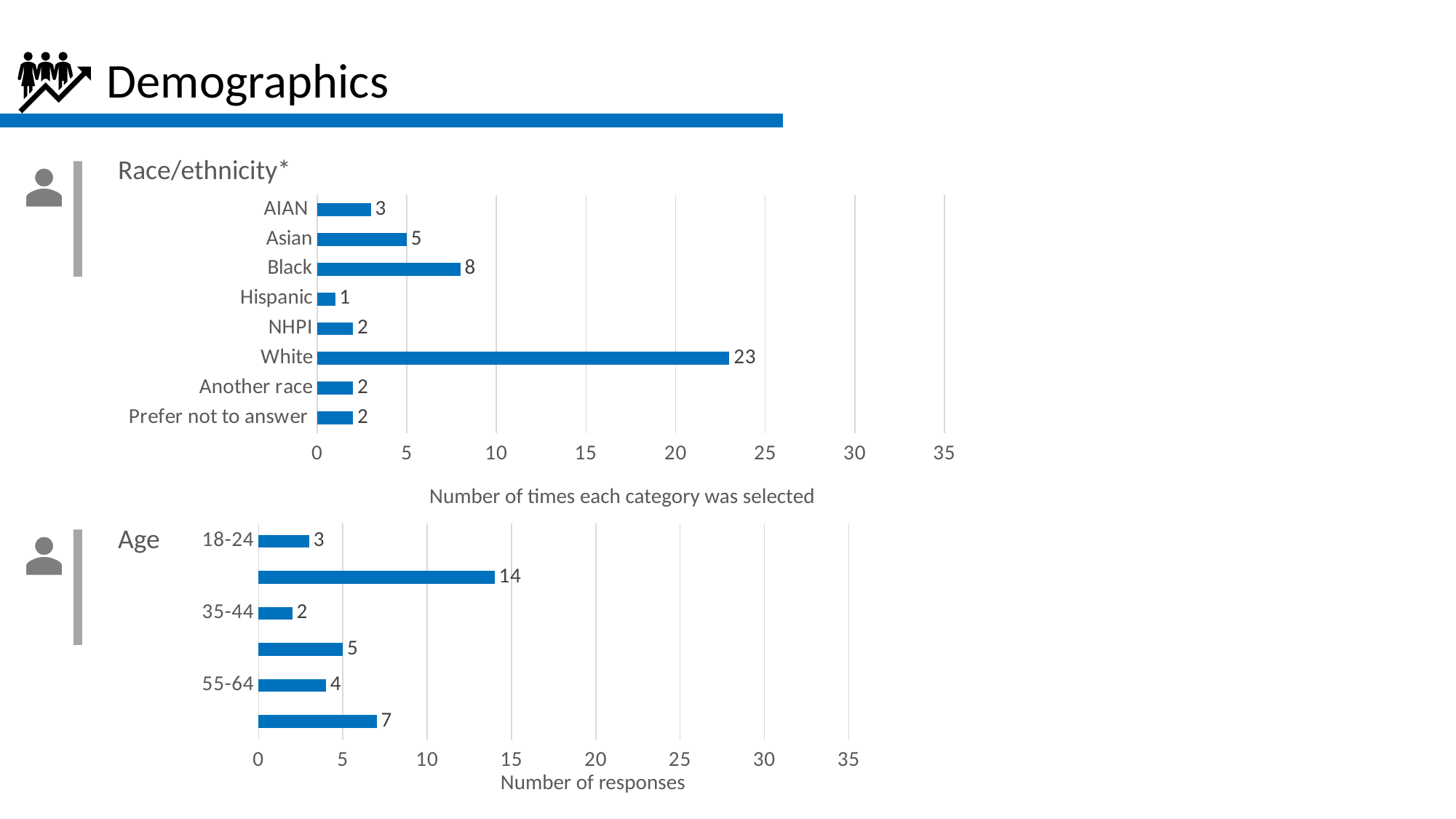
What kind of chart is the Age chart? Bar chart In the Race/ethnicity chart, what is the value for Black? 8 In the Race/ethnicity chart, which is larger, the value for Asian or the value for AIAN? Asian In the Race/ethnicity chart, how many times was White selected? 23 In the Age chart, what is the value for 18-24? 3 In the Age chart, what is the difference between the values for 55-64 and 35-44? 2 In the Race/ethnicity chart, is the value for White greater or less than 20? greater What is the x-axis title of the Age chart? Number of responses In the Race/ethnicity chart, which category has the highest value? White In the Race/ethnicity chart, which category has the lowest value? Hispanic In the Race/ethnicity chart, what is the difference between the values for White and Black? 15 In the Race/ethnicity chart, how many categories are shown? 8